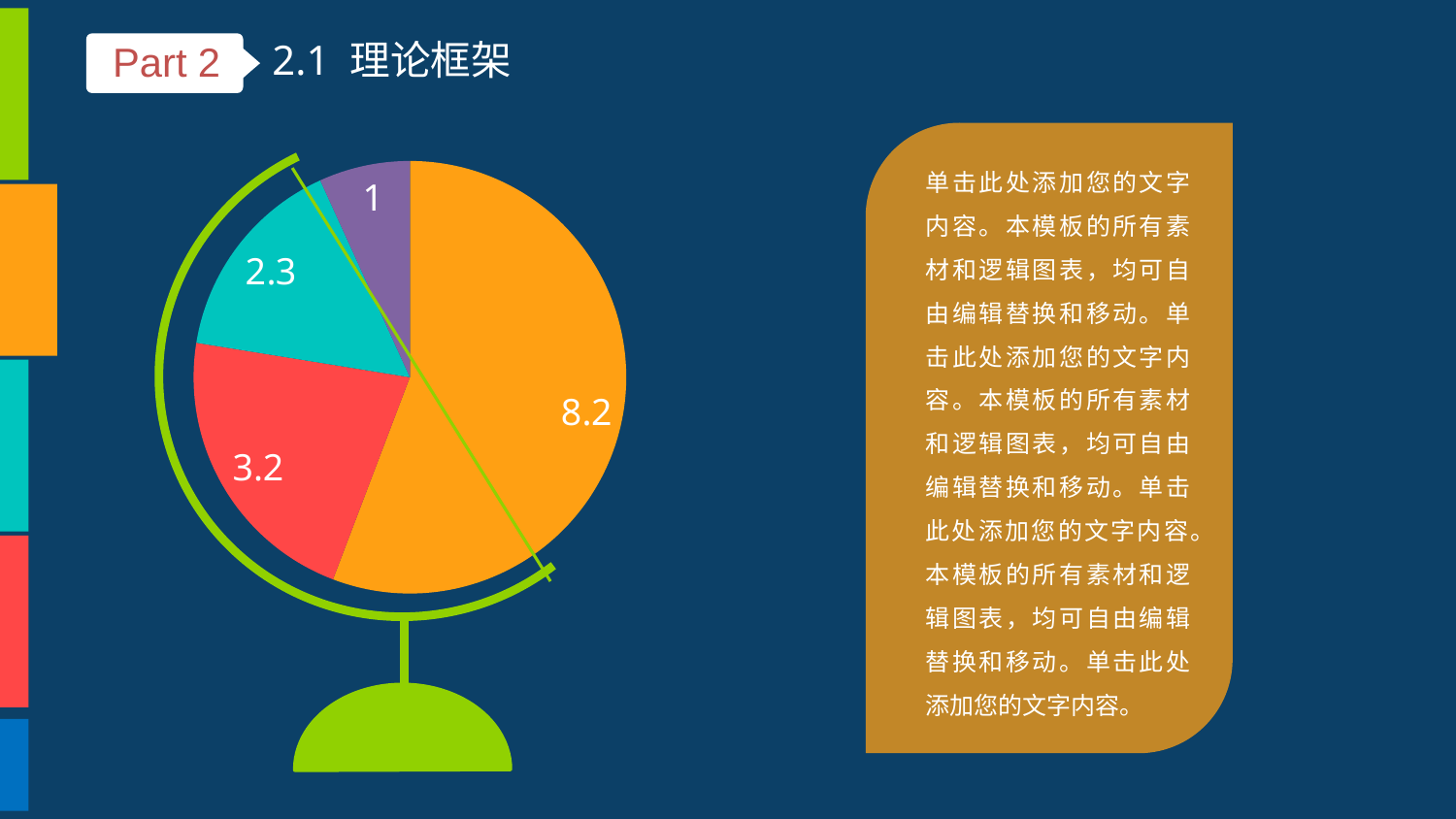
Which slice is larger, the red slice or the teal slice? the red slice What is the value of the largest slice of the pie chart? 8.2 What is the value of the smallest slice of the pie chart? 1 What value is labelled on the red slice of the pie chart? 3.2 What value is labelled on the purple slice of the pie chart? 1 What value is labelled on the orange slice of the pie chart? 8.2 How many slices does the pie chart have? 4 What colour is the largest slice of the pie chart? orange What kind of chart is shown on the slide? pie chart What value is labelled on the teal slice of the pie chart? 2.3 What is the sum of all four slice values in the pie chart? 14.7 What is the difference between the orange slice (8.2) and the red slice (3.2)? 5